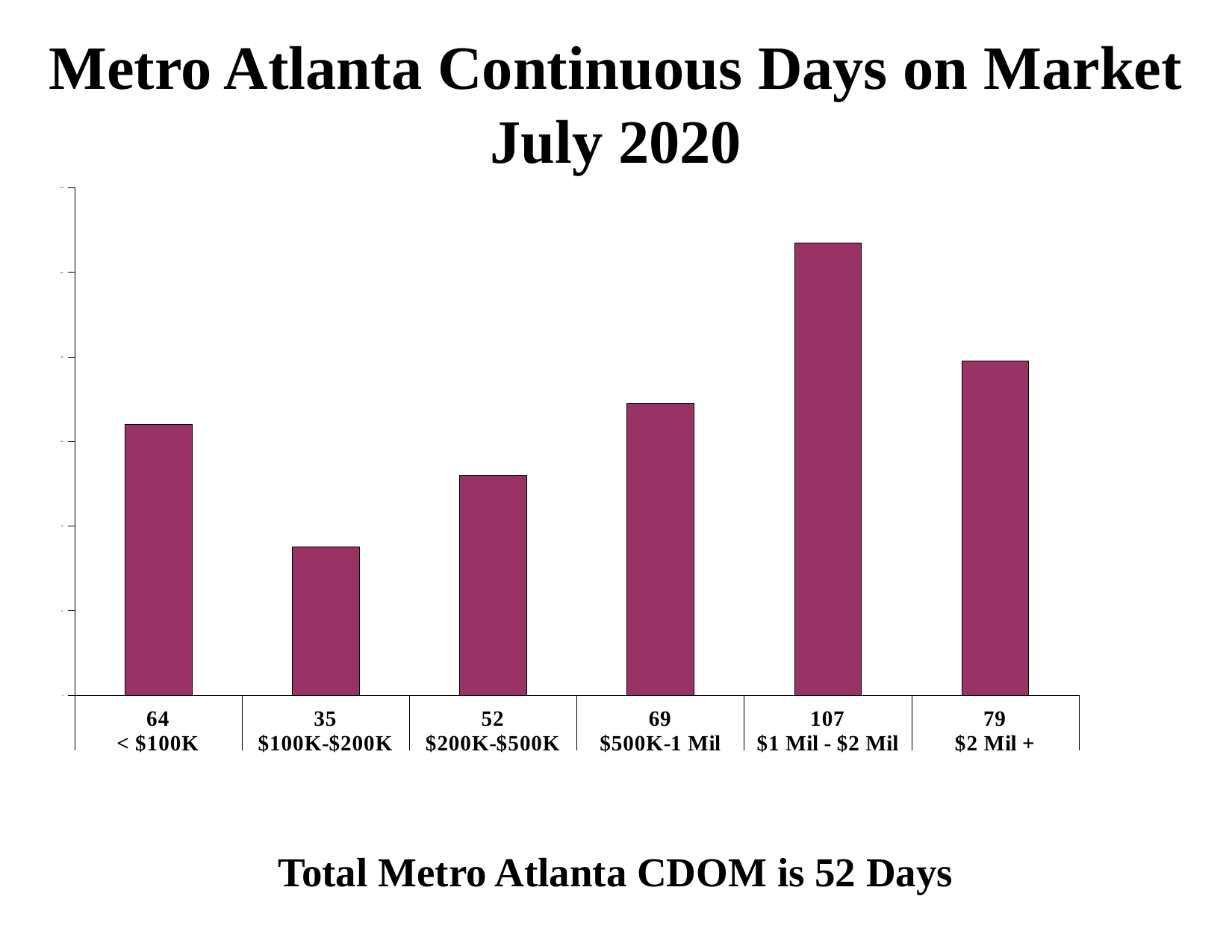
What is the difference in days on market between the $1 Mil - $2 Mil range and the $100K-$200K range? 72 How many price range categories are shown in the chart? 6 What type of chart is shown on the slide? Bar chart Which price range has the lowest continuous days on market? $100K-$200K What is the title of the chart? Metro Atlanta Continuous Days on Market July 2020 What is the continuous days on market value for the $2 Mil + price range? 79 What is the continuous days on market value for the $100K-$200K price range? 35 Which has more days on market, the < $100K range or the $2 Mil + range? $2 Mil + Which price range has the highest continuous days on market? $1 Mil - $2 Mil What is the difference in days on market between the $500K-1 Mil range and the $200K-$500K range? 17 What is the continuous days on market value for the $1 Mil - $2 Mil price range? 107 According to the text below the chart, what is the total Metro Atlanta CDOM? 52 Days